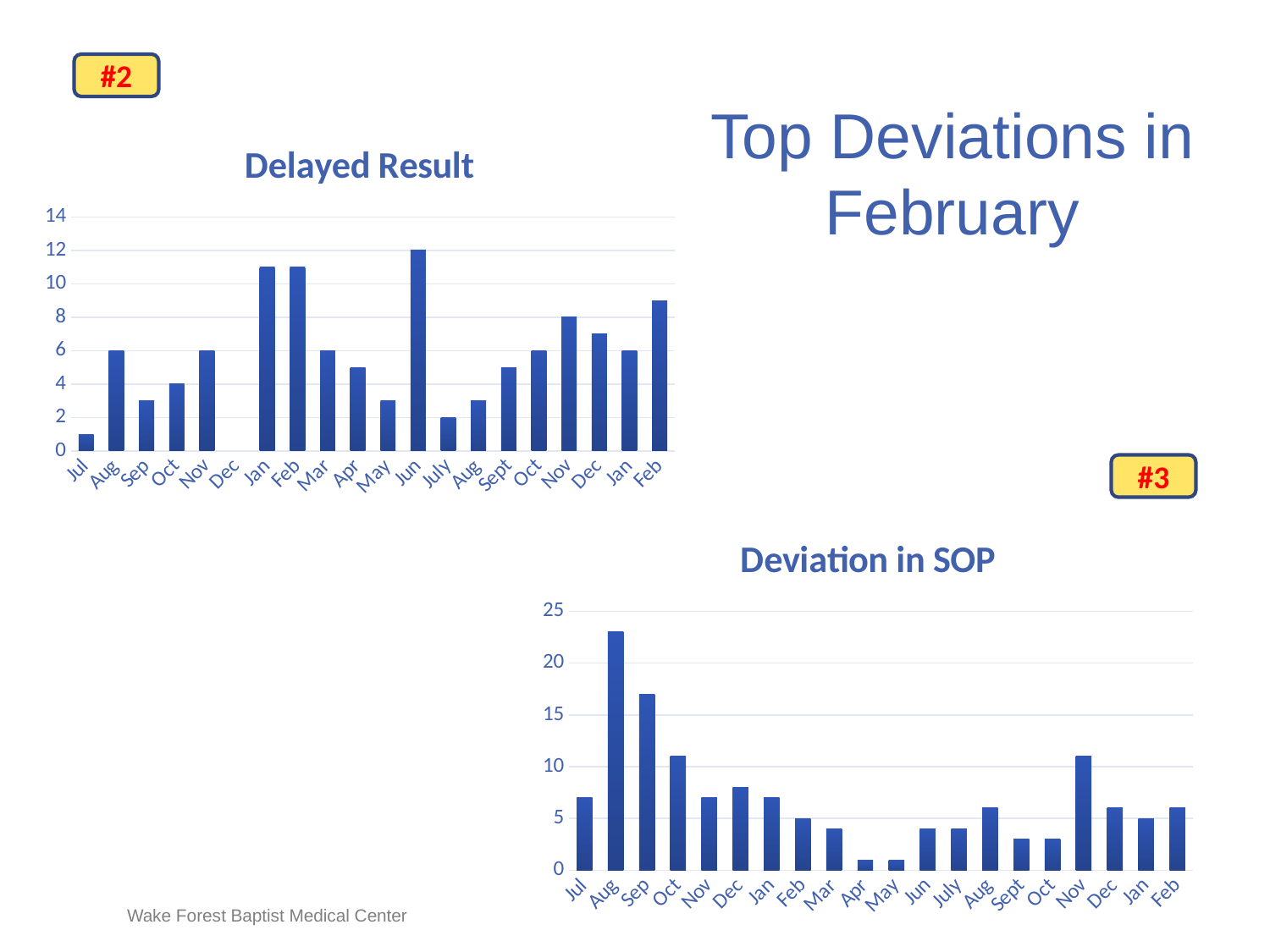
What is the title of the chart in the lower right of the slide? Deviation in SOP In the "Delayed Result" chart, which is larger, the value for Jun or the value for the last Feb bar? Jun How many month categories are shown on the x axis of the "Delayed Result" chart? 20 In the "Delayed Result" chart, is the value for the first Jan bar greater or less than 10? greater What type of chart is the "Delayed Result" chart? bar chart In the "Delayed Result" chart, which month has the highest bar? Jun In the "Deviation in SOP" chart, is the value for Mar greater or less than 5? less In the "Deviation in SOP" chart, is the value for the first Aug bar greater or less than 20? greater In the "Delayed Result" chart, what is the value for Jun? 12 In the "Delayed Result" chart, what is the value for July? 2 In the "Deviation in SOP" chart, which month has the highest bar? Aug